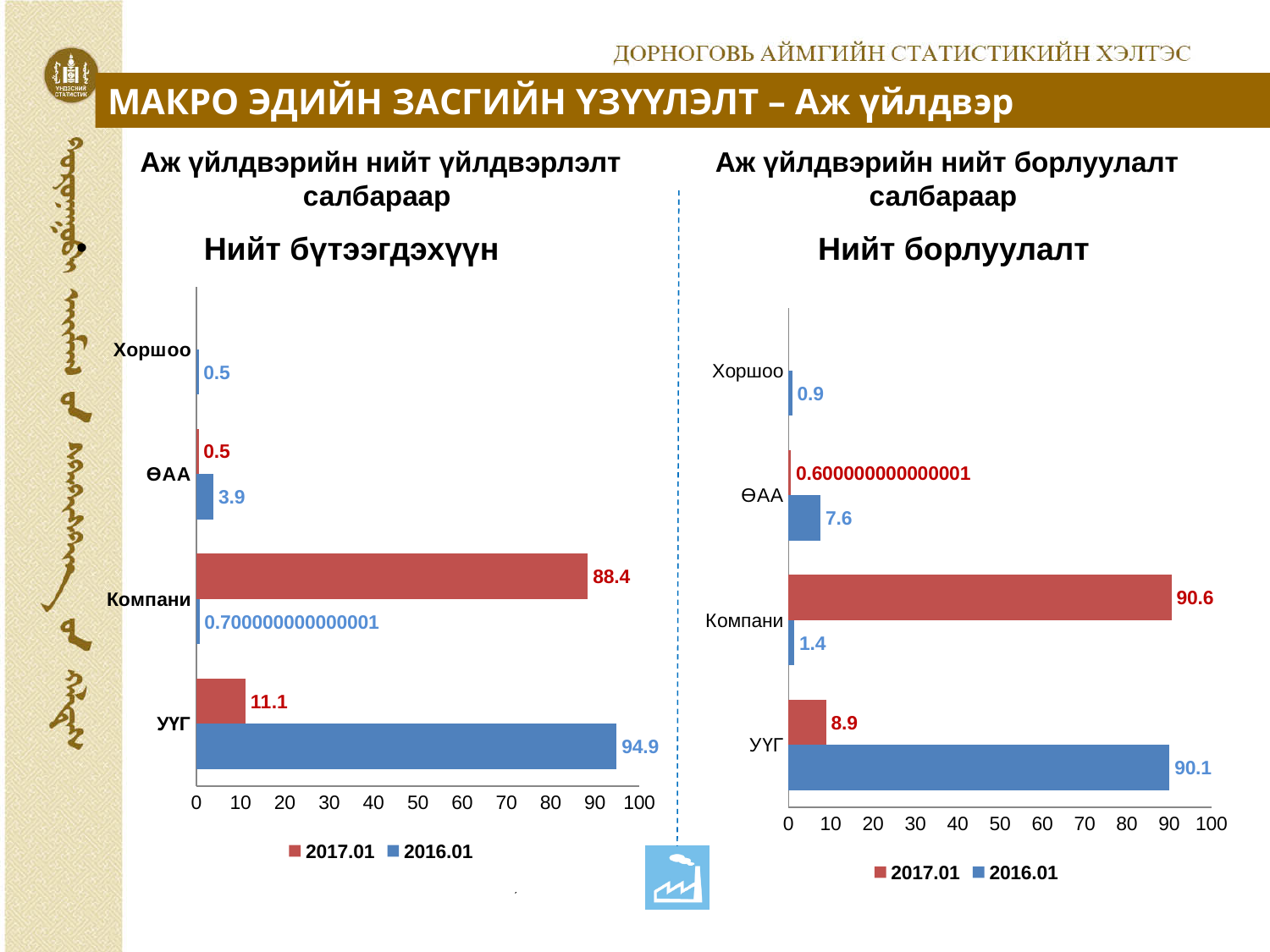
In the 'Нийт бүтээгдэхүүн' chart, how many series does the legend list? 2 In the 'Нийт бүтээгдэхүүн' chart, what is the 2017.01 value for Компани? 88.4 In the 'Нийт бүтээгдэхүүн' chart, which category has the highest 2016.01 value? УҮГ In the 'Нийт бүтээгдэхүүн' chart, what is the 2016.01 value for УҮГ? 94.9 In the 'Нийт борлуулалт' chart, which is larger for УҮГ: the 2017.01 value or the 2016.01 value? 2016.01 In the 'Нийт борлуулалт' chart, which category has the highest 2017.01 value? Компани In the 'Нийт борлуулалт' chart, what is the 2017.01 value for Компани? 90.6 In the 'Нийт бүтээгдэхүүн' chart, what is the 2017.01 value for УҮГ? 11.1 In the 'Нийт бүтээгдэхүүн' chart, what is the difference between the 2016.01 and 2017.01 values for УҮГ? 83.8 What type of chart is the 'Нийт борлуулалт' chart? Bar chart In the 'Нийт борлуулалт' chart, how many categories are shown on the vertical axis? 4 In the 'Нийт борлуулалт' chart, what is the 2016.01 value for ӨАА? 7.6